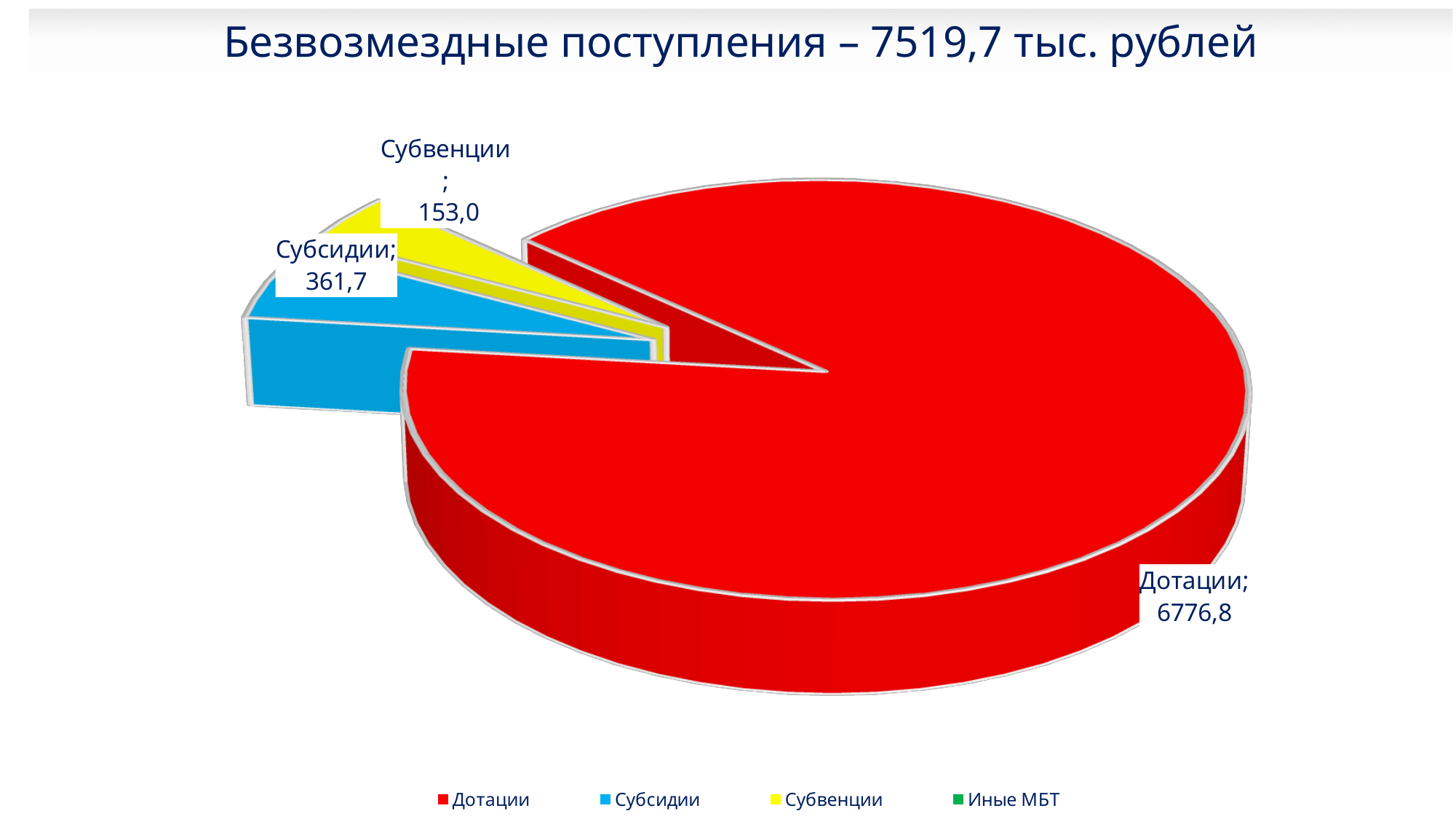
What type of chart is shown on the slide? pie chart What is the difference between the values for Дотации and Субсидии? 6415,1 What colour is the Субсидии slice? blue What is the title of the slide? Безвозмездные поступления – 7519,7 тыс. рублей What is the value shown for Субсидии? 361,7 Which of the two labeled slices is larger, Субсидии or Субвенции? Субсидии What is the difference between the values for Субсидии and Субвенции? 208,7 What is the value shown for Дотации? 6776,8 What is the value shown for Субвенции? 153,0 Which category has the largest slice of the pie? Дотации How many entries does the legend list? 4